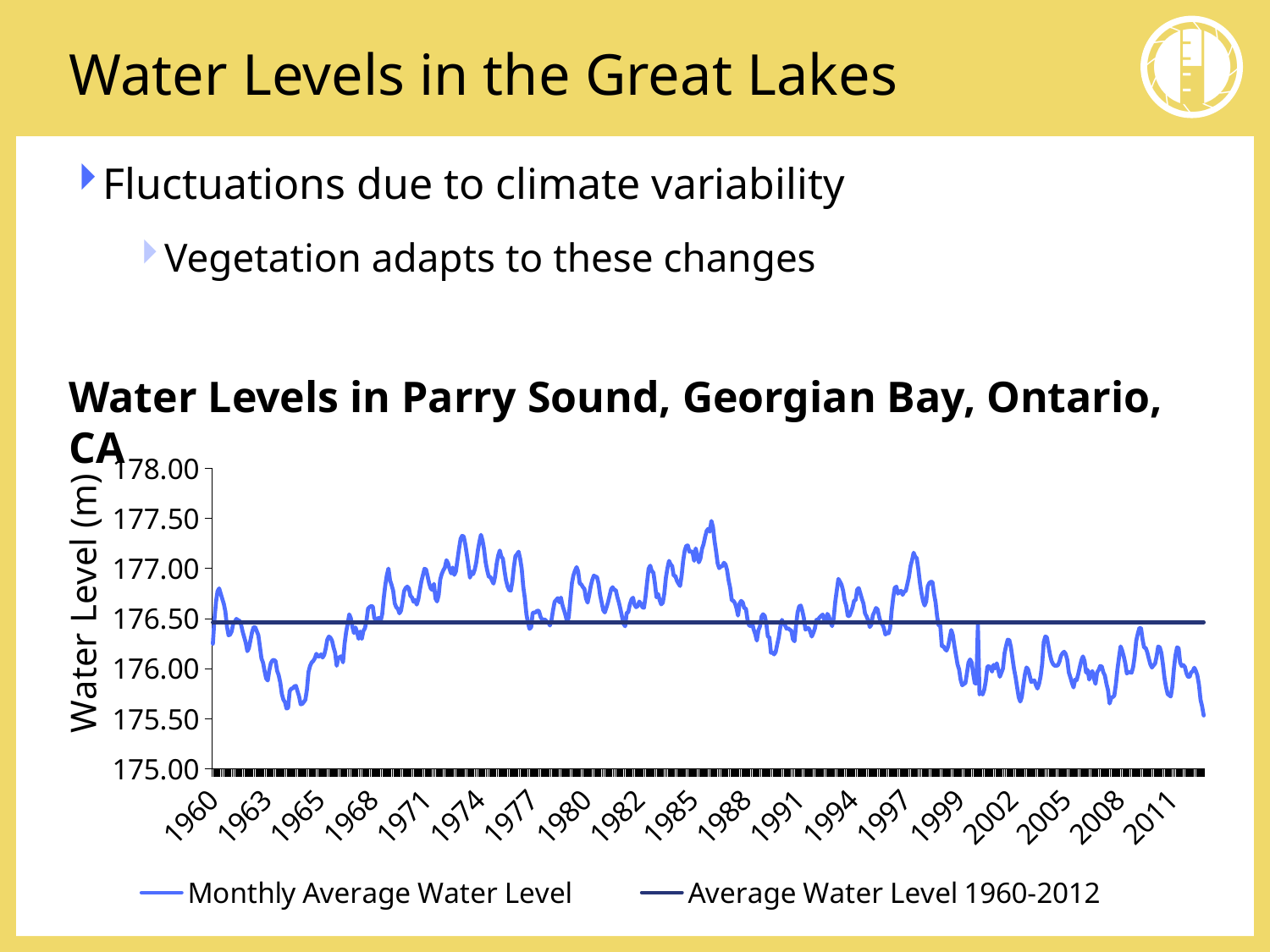
How many series does the chart legend list? 2 Is the Monthly Average Water Level around 1964 greater or less than 176.00? less Is the peak Monthly Average Water Level around 1986 greater or less than 177.00? greater What kind of chart is shown on the slide? Line chart What is the label on the vertical axis of the chart? Water Level (m) What is the title of the chart? Water Levels in Parry Sound, Georgian Bay, Ontario, CA Is the Monthly Average Water Level around 2000 greater or less than 176.50? less Overall, does the Monthly Average Water Level rise or fall from 1960 to the end of the series in 2012? fall Around which year does the Monthly Average Water Level reach its highest point? 1986 Is the Monthly Average Water Level higher around 1986 or around 2000? 1986